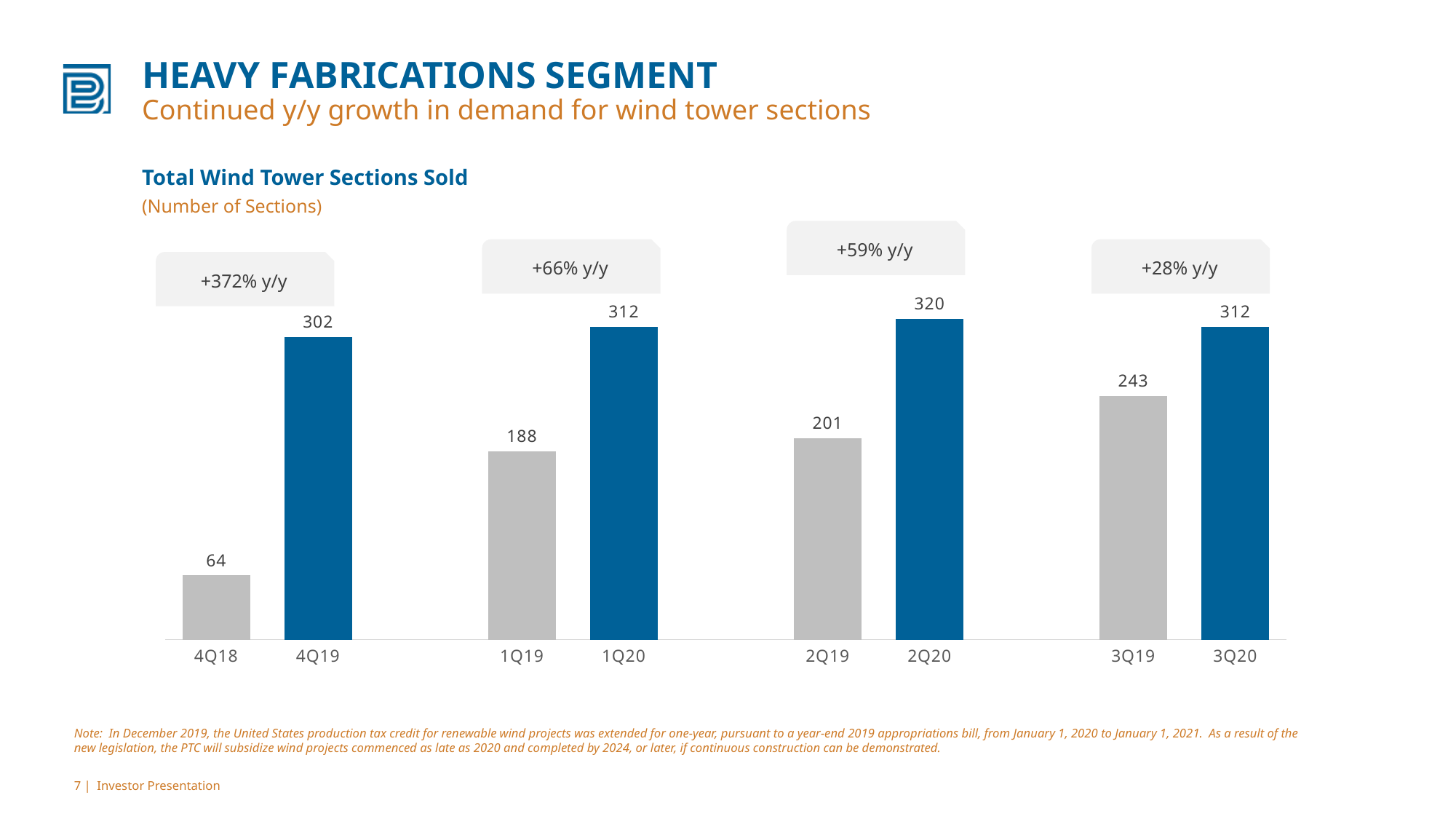
Which quarter has the highest number of wind tower sections sold? 2Q20 What is the number of wind tower sections sold in 1Q19? 188 What year-over-year growth percentage is shown above the 2Q19/2Q20 pair of bars? +59% y/y Which quarter had more sections sold, 2Q19 or 3Q19? 3Q19 What is the difference in sections sold between 3Q20 and 3Q19? 69 What is the number of wind tower sections sold in 4Q19? 302 How many quarters are shown on the chart? 8 What is the difference in sections sold between 4Q19 and 4Q18? 238 What kind of chart is used to show Total Wind Tower Sections Sold? Bar chart What is the number of wind tower sections sold in 3Q19? 243 What is the title of the chart? Total Wind Tower Sections Sold Which quarter has the lowest number of wind tower sections sold? 4Q18